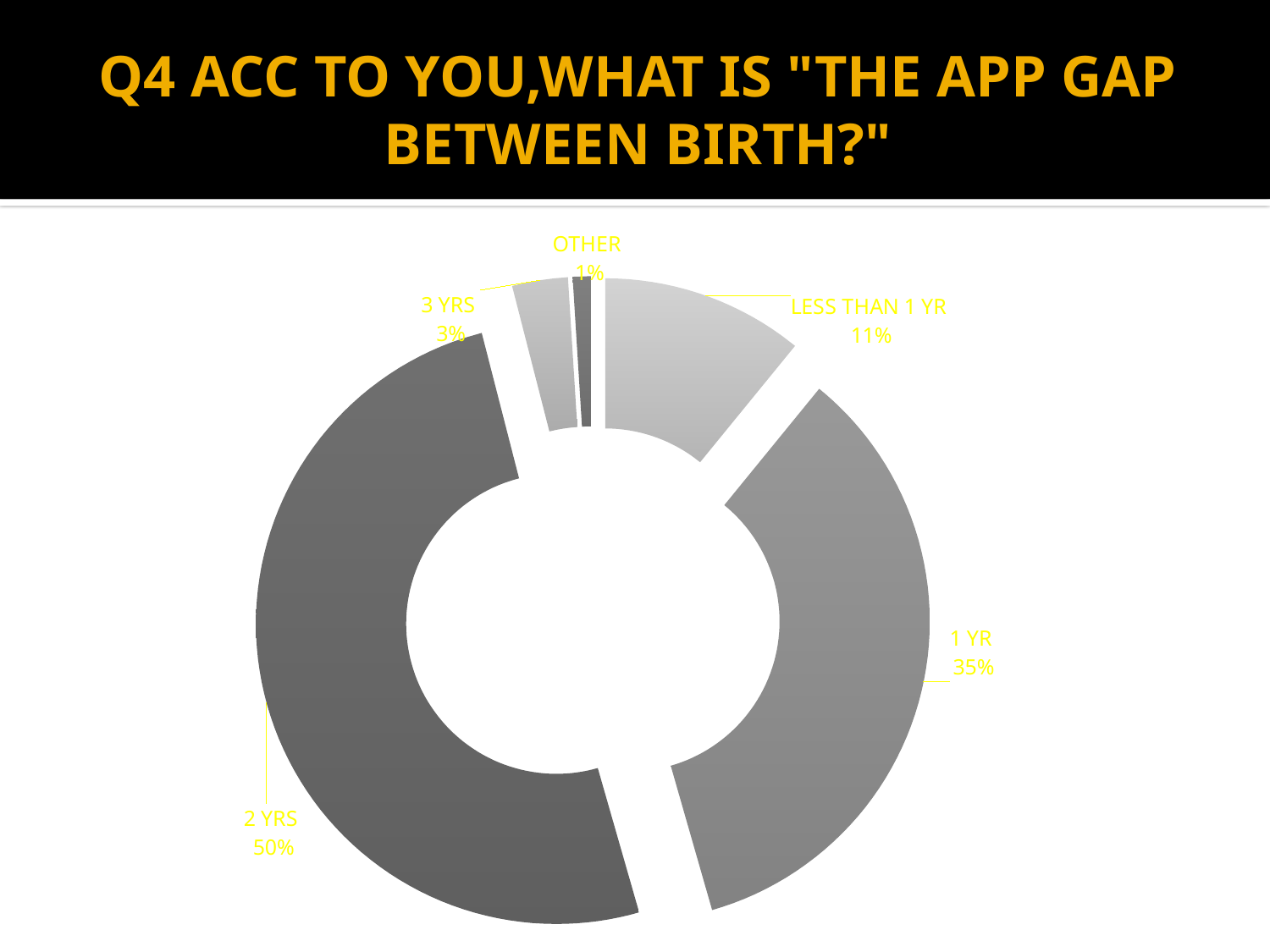
What is the combined share of 1 YR and 2 YRS? 85% What percentage is shown for LESS THAN 1 YR? 11% What percentage is shown for OTHER? 1% What is the difference in percentage points between 2 YRS and 1 YR? 15 What percentage is shown for 1 YR? 35% Which is larger, the share for LESS THAN 1 YR or the share for 3 YRS? LESS THAN 1 YR What percentage is shown for 3 YRS? 3% What kind of chart is shown on the slide? Doughnut chart Which category has the smallest share of the chart? OTHER How many categories are shown in the chart? 5 What share of respondents answered 2 YRS? 50% Which category has the largest share of the chart? 2 YRS